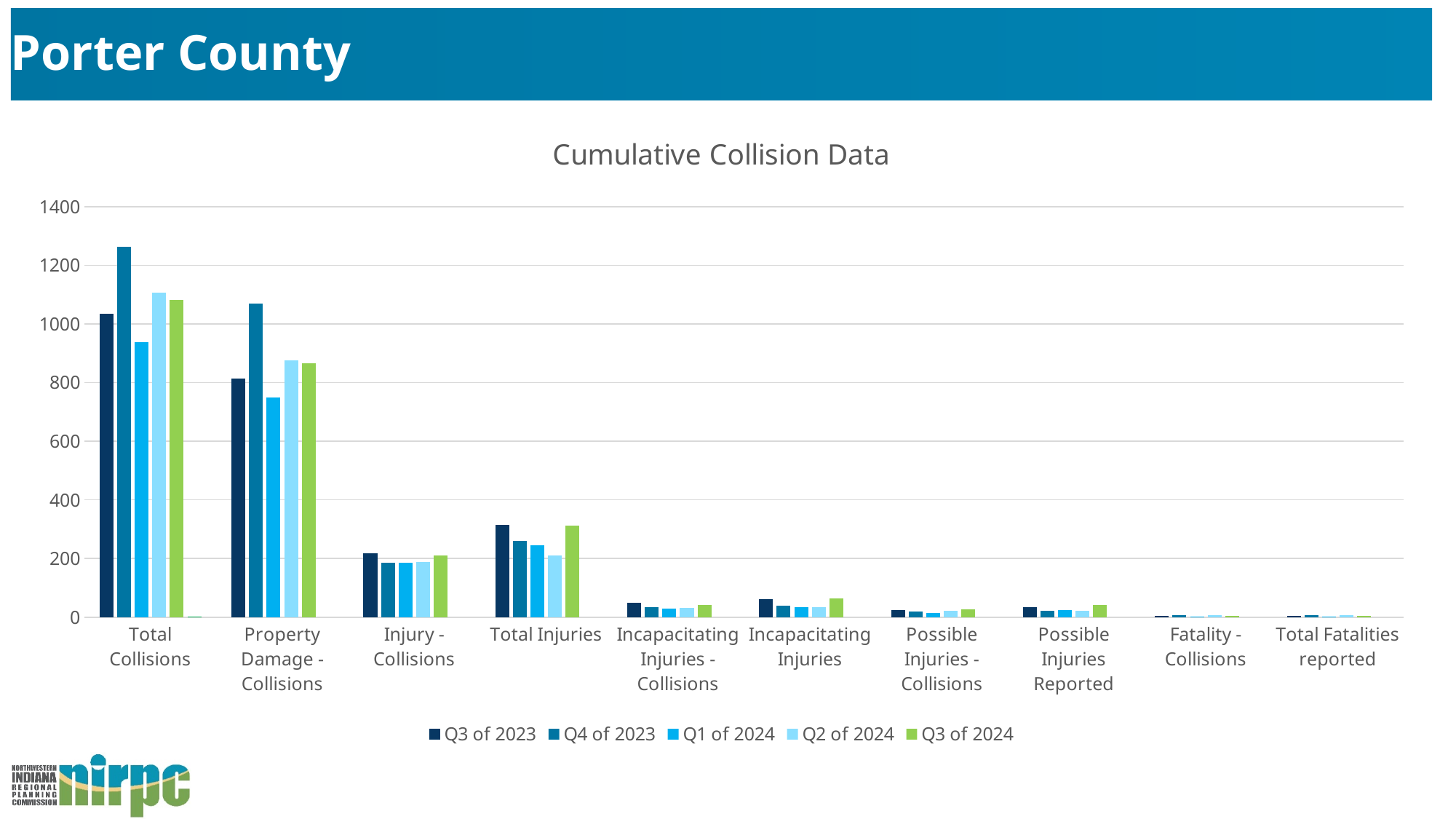
Is the value for Property Damage - Collisions in Q1 of 2024 greater or less than 800? less For Total Injuries, which is larger: Q3 of 2023 or Q4 of 2023? Q3 of 2023 Is the value for Total Collisions in Q4 of 2023 greater or less than 1200? greater Which quarter has the highest value for Total Collisions? Q4 of 2023 How many series does the legend list? 5 Is the value for Total Injuries in Q4 of 2023 greater or less than 300? less How many categories are shown on the x axis? 10 What is the title of the chart? Cumulative Collision Data Which quarter has the lowest value for Property Damage - Collisions? Q1 of 2024 What type of chart is shown on the slide? bar chart